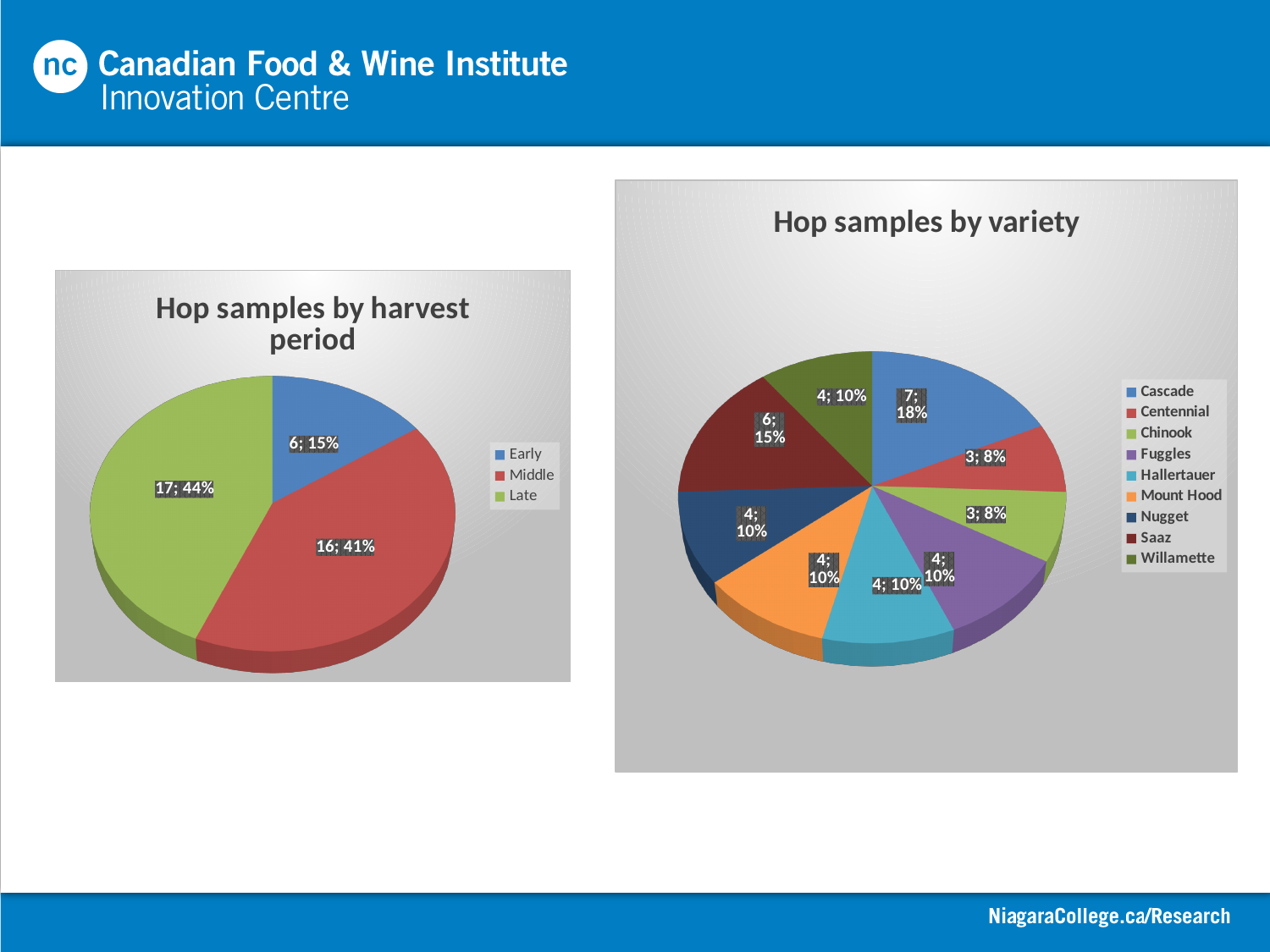
In the 'Hop samples by variety' chart, which variety has the most samples? Cascade In the 'Hop samples by harvest period' chart, what is the difference in sample count between Late and Early? 11 In the 'Hop samples by variety' chart, how many varieties are listed in the legend? 9 What kind of chart is 'Hop samples by variety'? Pie chart In the 'Hop samples by harvest period' chart, what share of the pie does the Late slice represent? 44% In the 'Hop samples by harvest period' chart, which harvest period has the fewest samples? Early In the 'Hop samples by harvest period' chart, how many categories does the legend list? 3 In the 'Hop samples by harvest period' chart, how many samples are in the Middle harvest period? 16 In the 'Hop samples by variety' chart, which has more samples, Saaz or Centennial? Saaz In the 'Hop samples by variety' chart, what colour is the Mount Hood slice? Orange In the 'Hop samples by variety' chart, how many samples are Cascade? 7 In the 'Hop samples by variety' chart, what share of the pie does Saaz represent? 15%